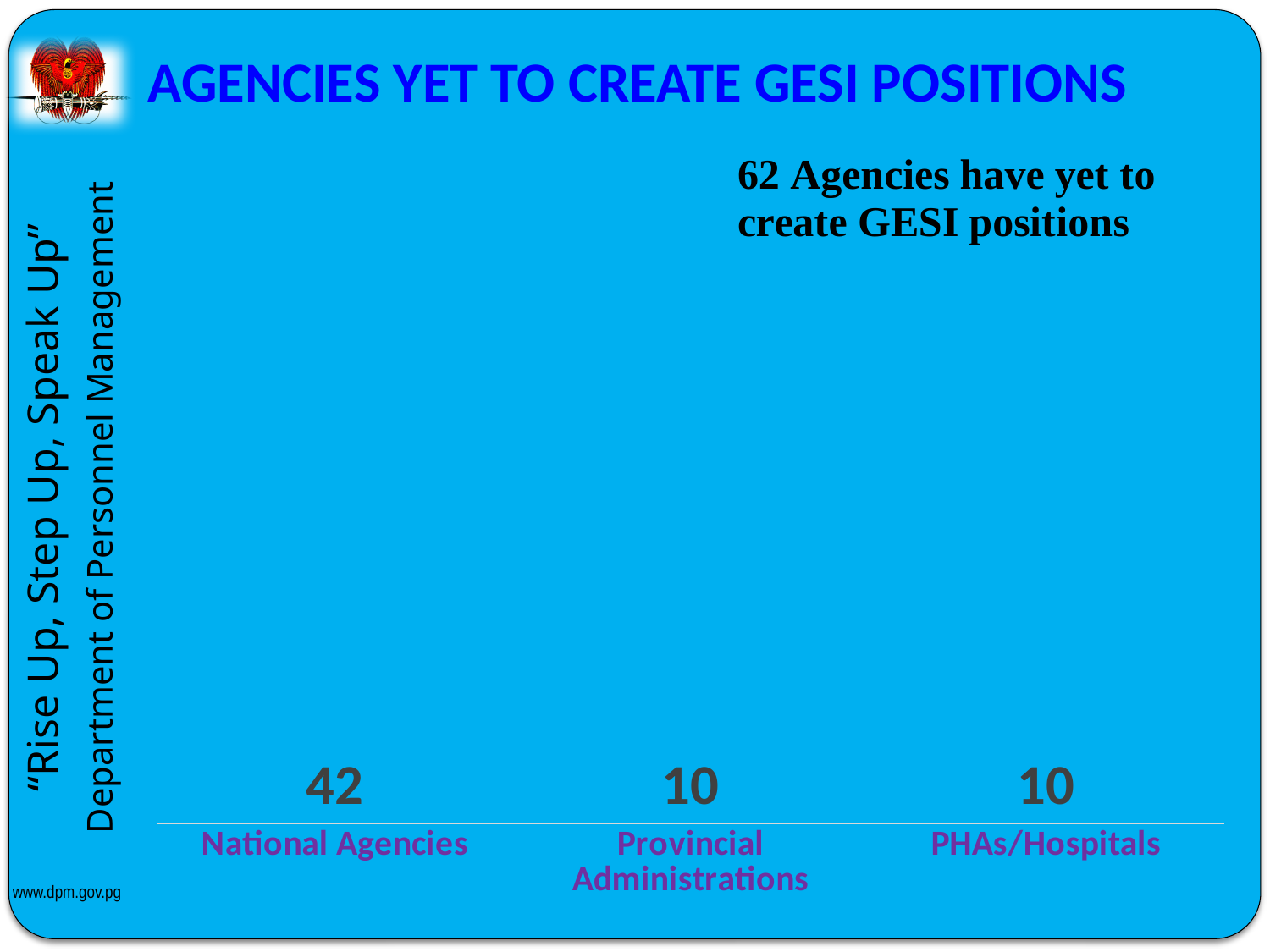
What is the total of the three values shown in the chart? 62 What is the value for Provincial Administrations? 10 According to the text beside the chart, how many agencies have yet to create GESI positions? 62 What is the value for National Agencies? 42 What is the difference between the values for National Agencies and Provincial Administrations? 32 Which category has the highest value? National Agencies What is the value for PHAs/Hospitals? 10 What is the title of the slide containing the chart? AGENCIES YET TO CREATE GESI POSITIONS Do the values for Provincial Administrations and PHAs/Hospitals differ? No, both are 10 Which is larger, the value for National Agencies or the value for PHAs/Hospitals? National Agencies What is the difference between the values for National Agencies and PHAs/Hospitals? 32 How many categories are shown in the chart? 3